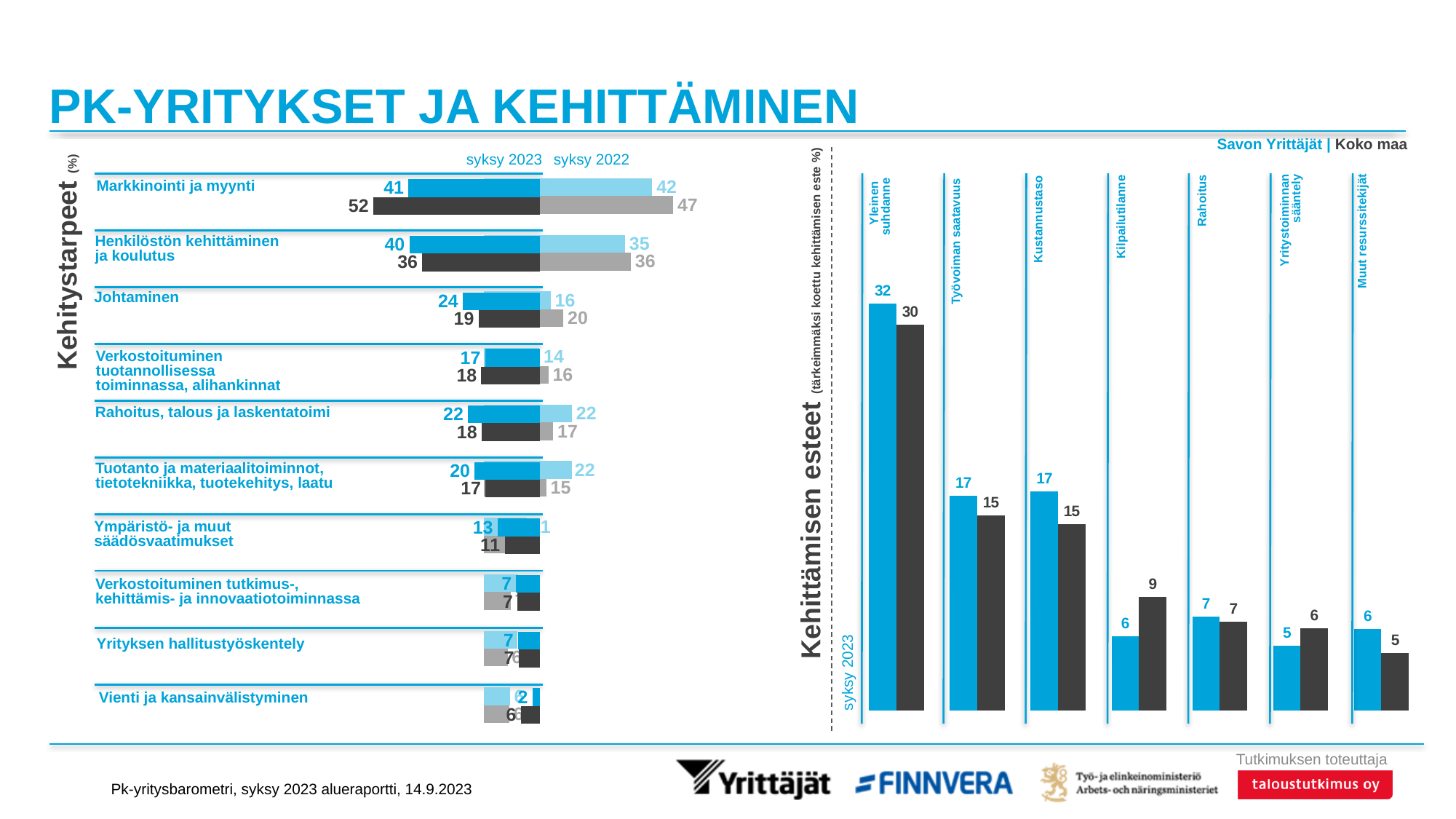
In the Kehitystarpeet chart on the left, what is the syksy 2023 value for Koko maa for Markkinointi ja myynti? 52 In the Kehittämisen esteet chart on the right, what is the value for Savon Yrittäjät for Yleinen suhdanne? 32 In the Kehitystarpeet chart on the left, which is larger for Henkilöstön kehittäminen ja koulutus in syksy 2023: Savon Yrittäjät or Koko maa? Savon Yrittäjät In the Kehittämisen esteet chart on the right, which category has the lowest Savon Yrittäjät value? Yritystoiminnan sääntely In the Kehitystarpeet chart on the left, what is the difference between the syksy 2023 Savon Yrittäjät and Koko maa values for Markkinointi ja myynti? 11 In the Kehitystarpeet chart on the left, what is the syksy 2023 value for Savon Yrittäjät for Johtaminen? 24 In the Kehittämisen esteet chart on the right, what is the Koko maa value for Kilpailutilanne? 9 In the Kehitystarpeet chart on the left, what is the syksy 2022 value for Koko maa for Markkinointi ja myynti? 47 In the Kehittämisen esteet chart on the right, which category has the highest value for Savon Yrittäjät? Yleinen suhdanne In the Kehittämisen esteet chart on the right, what is the difference between the Savon Yrittäjät and Koko maa values for Yleinen suhdanne? 2 In the Kehittämisen esteet chart on the right, how many categories are shown? 7 What type of chart is the Kehittämisen esteet chart on the right? Bar chart